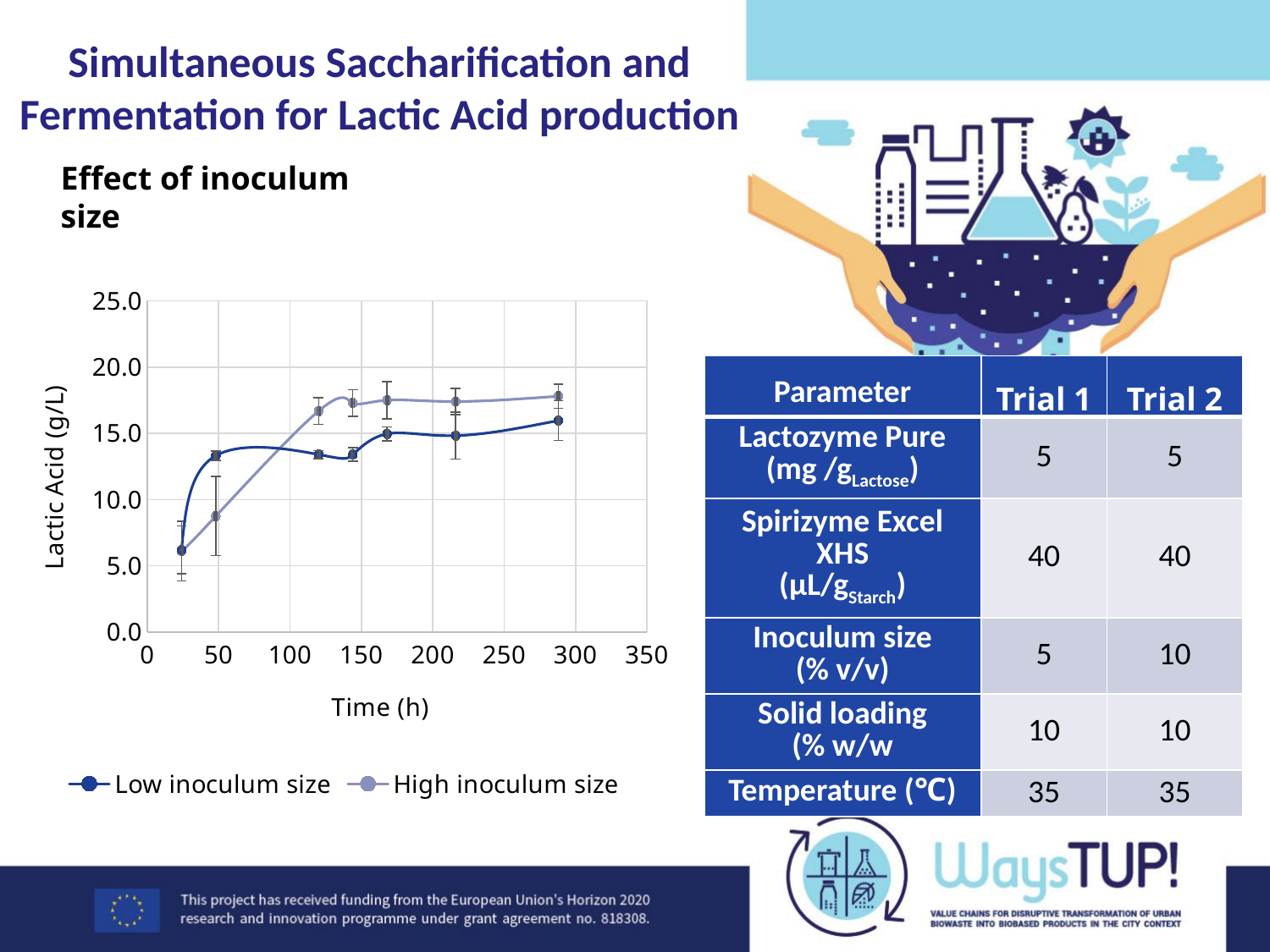
Is the lactic acid value for High inoculum size at around 50 h greater or less than 10.0 g/L? less Is the lactic acid value for Low inoculum size at around 120 h greater or less than 15.0 g/L? less At around 50 h, which series has the higher lactic acid concentration, Low inoculum size or High inoculum size? Low inoculum size Overall, does the lactic acid concentration for High inoculum size rise or fall as time increases? rise Is the lactic acid value for High inoculum size at the final time point (around 290 h) greater or less than 15.0 g/L? greater What kind of chart is shown on the slide? line chart How many series does the chart legend list? 2 What are the two series named in the chart legend? Low inoculum size and High inoculum size At the final time point (around 290 h), which series has the higher lactic acid concentration, Low inoculum size or High inoculum size? High inoculum size What is the label of the y axis of the chart? Lactic Acid (g/L) How many data points are plotted for the Low inoculum size series? 7